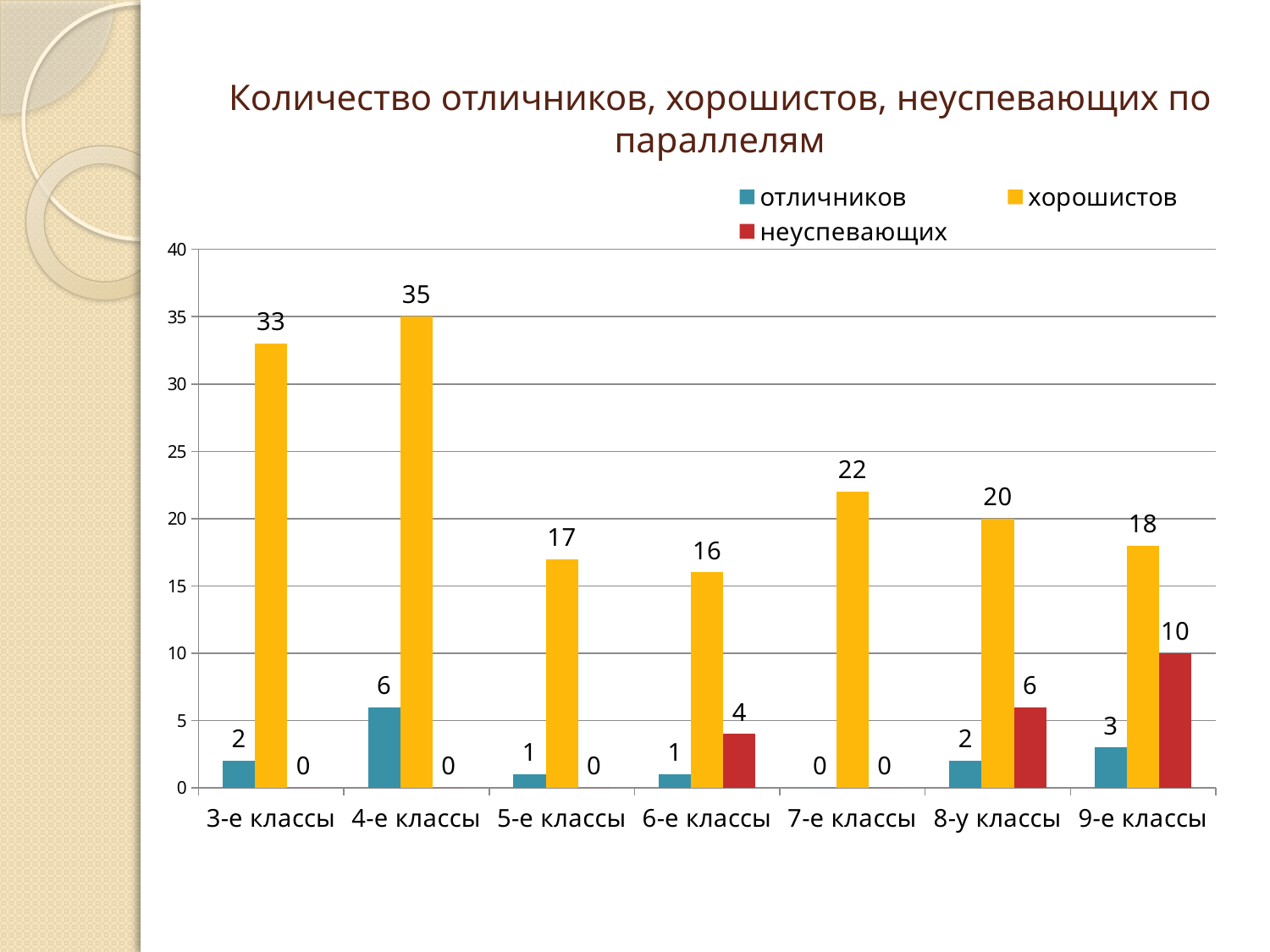
What is the value for неуспевающих in 6-е классы? 4 Which is larger: the отличников value for 4-е классы or for 8-у классы? 4-е классы What is the difference between the хорошистов values for 3-е классы and 9-е классы? 15 What kind of chart is shown on the slide? bar chart Which category has the highest value for хорошистов? 4-е классы What is the value for хорошистов in 4-е классы? 35 Which category has the lowest value for хорошистов? 6-е классы Which category has the highest value for неуспевающих? 9-е классы How many series does the legend list? 3 How many categories (class parallels) are shown on the x axis? 7 What is the title of the chart? Количество отличников, хорошистов, неуспевающих по параллелям What is the value for отличников in 9-е классы? 3